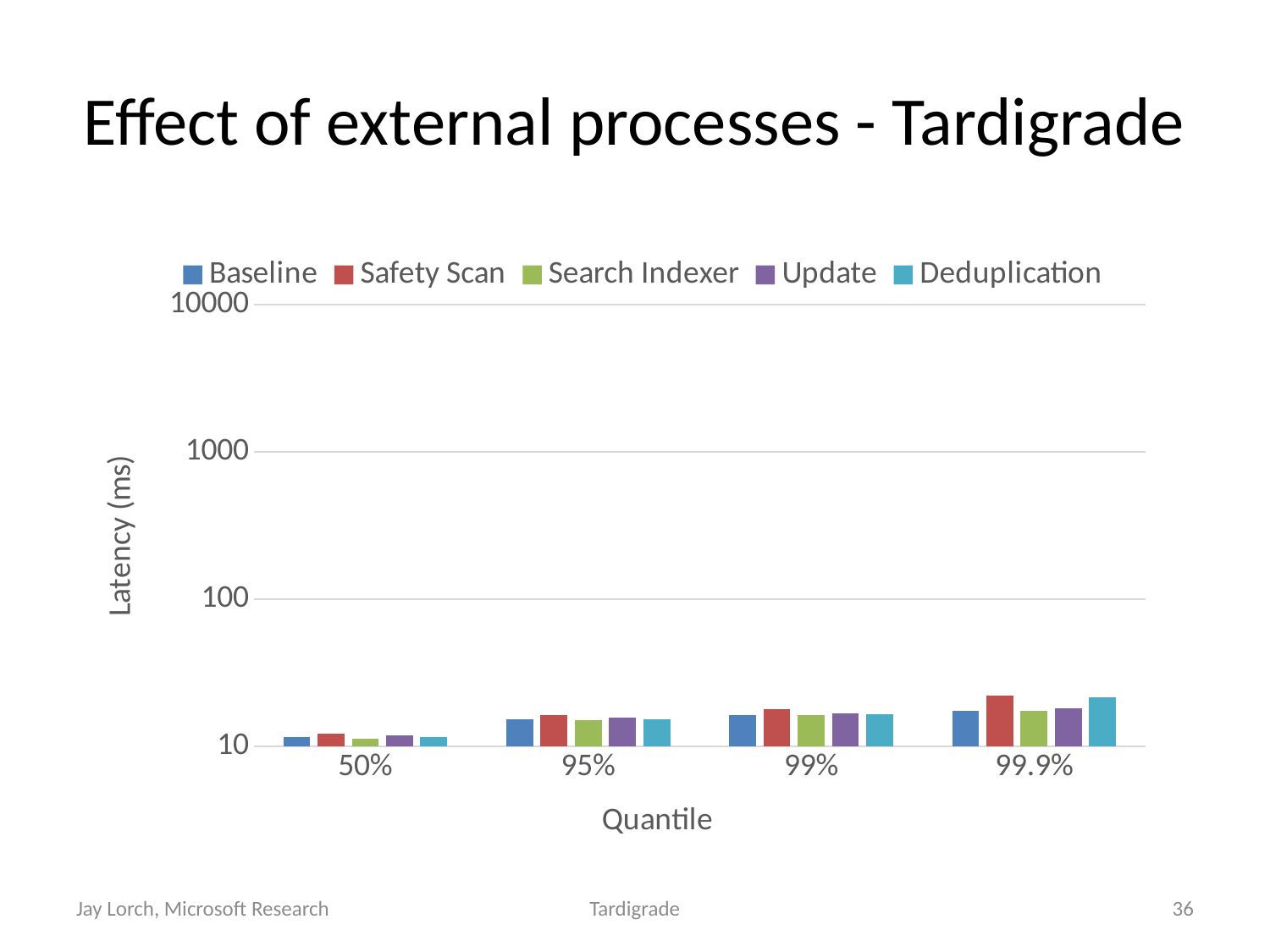
Which is larger: the Baseline latency at the 50% quantile or at the 99.9% quantile? 99.9% Is the Deduplication latency at the 99.9% quantile greater or less than 10 ms? greater Is the Baseline latency at the 99.9% quantile greater or less than 100 ms? less How many series does the legend list? 5 Does the Baseline latency rise or fall as the quantile increases from 50% to 99.9%? rise What is the title of the chart's x axis? Quantile What kind of chart is shown on the slide? bar chart How many quantile categories are shown on the x axis? 4 At the 99% quantile, which is larger: the Baseline latency or the Safety Scan latency? Safety Scan Is the Safety Scan latency at the 50% quantile greater or less than 100 ms? less What is the title of the chart's y axis? Latency (ms)